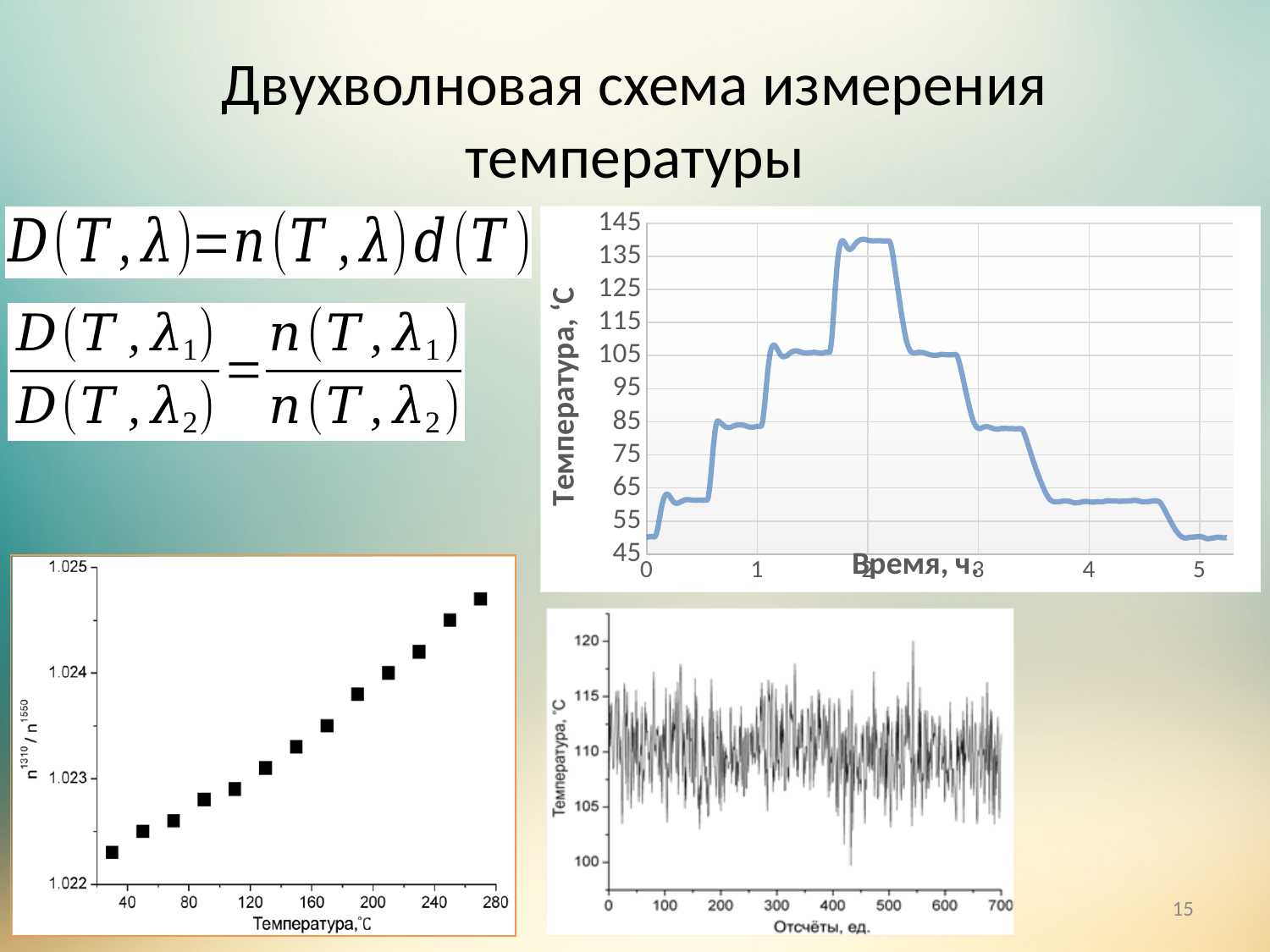
What kind of chart is the top-right chart (Температура vs Время)? line chart What is the x-axis label of the bottom-right chart? Отсчёты, ед. In the top-right chart, is the temperature at time 0 h greater or less than 55? less In the top-right chart, is the temperature at time 4 h greater or less than 75? less In the bottom-left chart, do the values rise or fall as temperature increases? rise In the top-right chart, is the temperature at time 1 h greater or less than 75? greater How many data points are plotted in the bottom-left chart? 13 What kind of chart is the bottom-left chart (n1310/n1550 vs Температура)? scatter chart